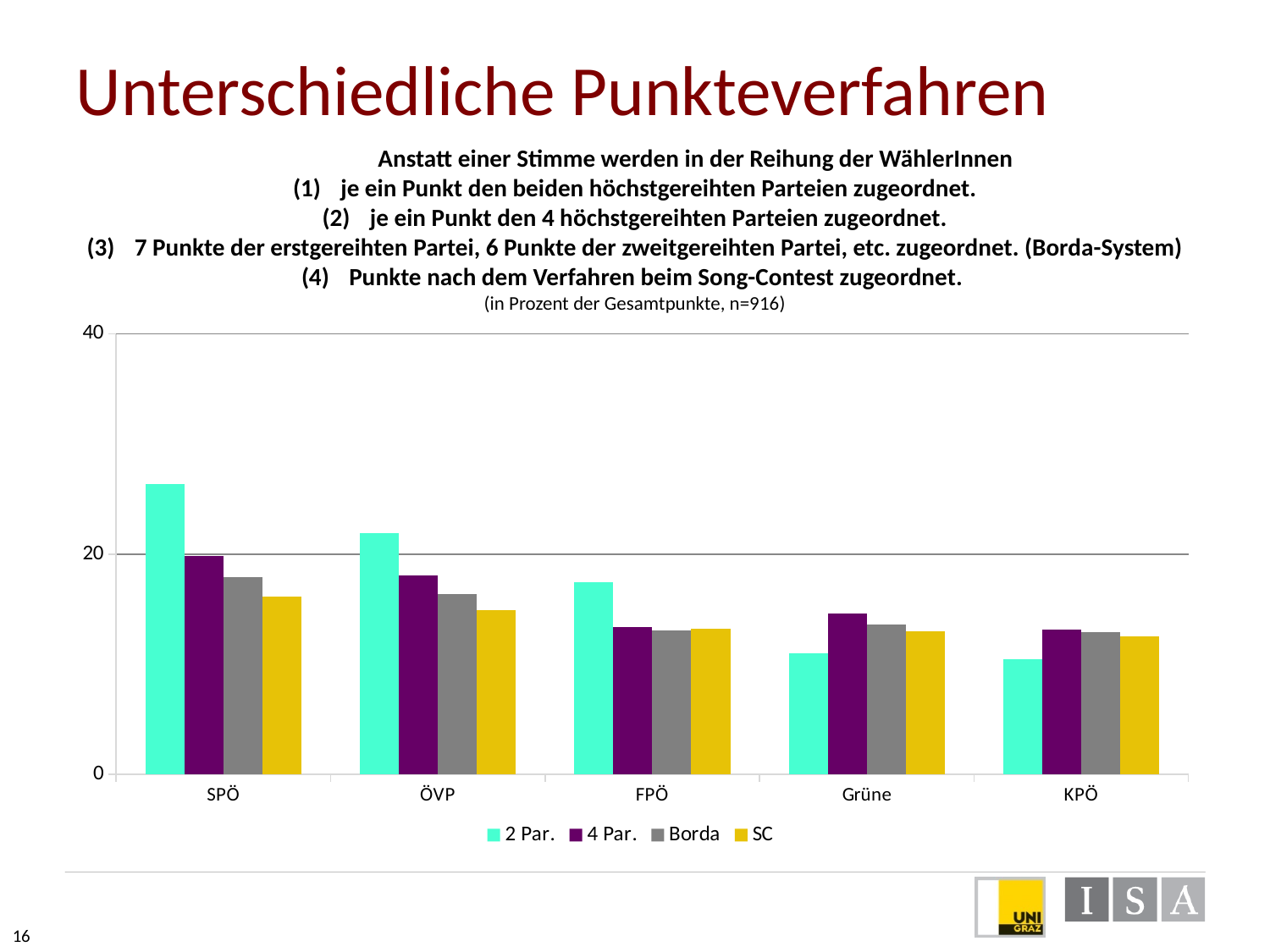
Which is larger: the '2 Par.' value for SPÖ or the '2 Par.' value for ÖVP? SPÖ Is the '2 Par.' value for ÖVP greater or less than 20? greater Is the '2 Par.' value for FPÖ greater or less than 20? less Is the '2 Par.' value for SPÖ greater or less than 20? greater Which party has the highest value in the 'SC' series? SPÖ How many parties (categories) are shown on the x axis of the chart? 5 For Grüne, which is larger: the '2 Par.' value or the '4 Par.' value? 4 Par. Which party has the highest value in the '2 Par.' series? SPÖ How many series does the chart's legend list? 4 Does the '2 Par.' series rise or fall moving from SPÖ to KPÖ along the x axis? fall What kind of chart is shown on the slide? bar chart